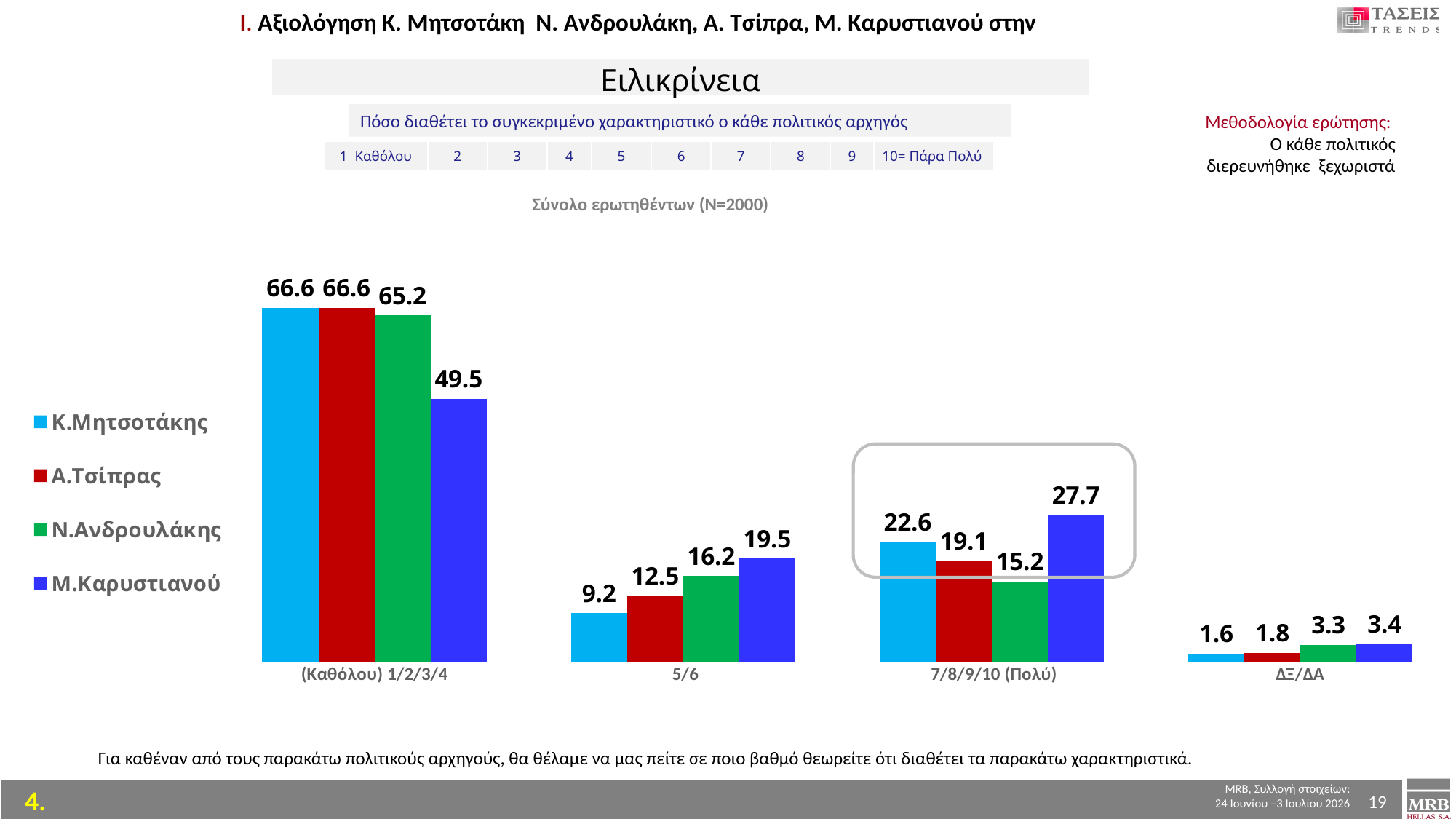
What kind of chart is shown on the slide? bar chart How many series does the legend list? 4 What is the value for Ν.Ανδρουλάκης in the 5/6 category? 16.2 What is the value for Μ.Καρυστιανού in the (Καθόλου) 1/2/3/4 category? 49.5 How many categories are shown on the x axis of the chart? 4 What is the value for Κ.Μητσοτάκης in the 7/8/9/10 (Πολύ) category? 22.6 Which series is shown in red in the chart? Α.Τσίπρας What is the difference between the values for Κ.Μητσοτάκης and Μ.Καρυστιανού in the (Καθόλου) 1/2/3/4 category? 17.1 Which series has the lowest value in the ΔΞ/ΔΑ category? Κ.Μητσοτάκης What is the difference between the values for Μ.Καρυστιανού and Ν.Ανδρουλάκης in the 7/8/9/10 (Πολύ) category? 12.5 In the 5/6 category, which is larger: the value for Α.Τσίπρας or the value for Μ.Καρυστιανού? Μ.Καρυστιανού Which series has the highest value in the 7/8/9/10 (Πολύ) category? Μ.Καρυστιανού